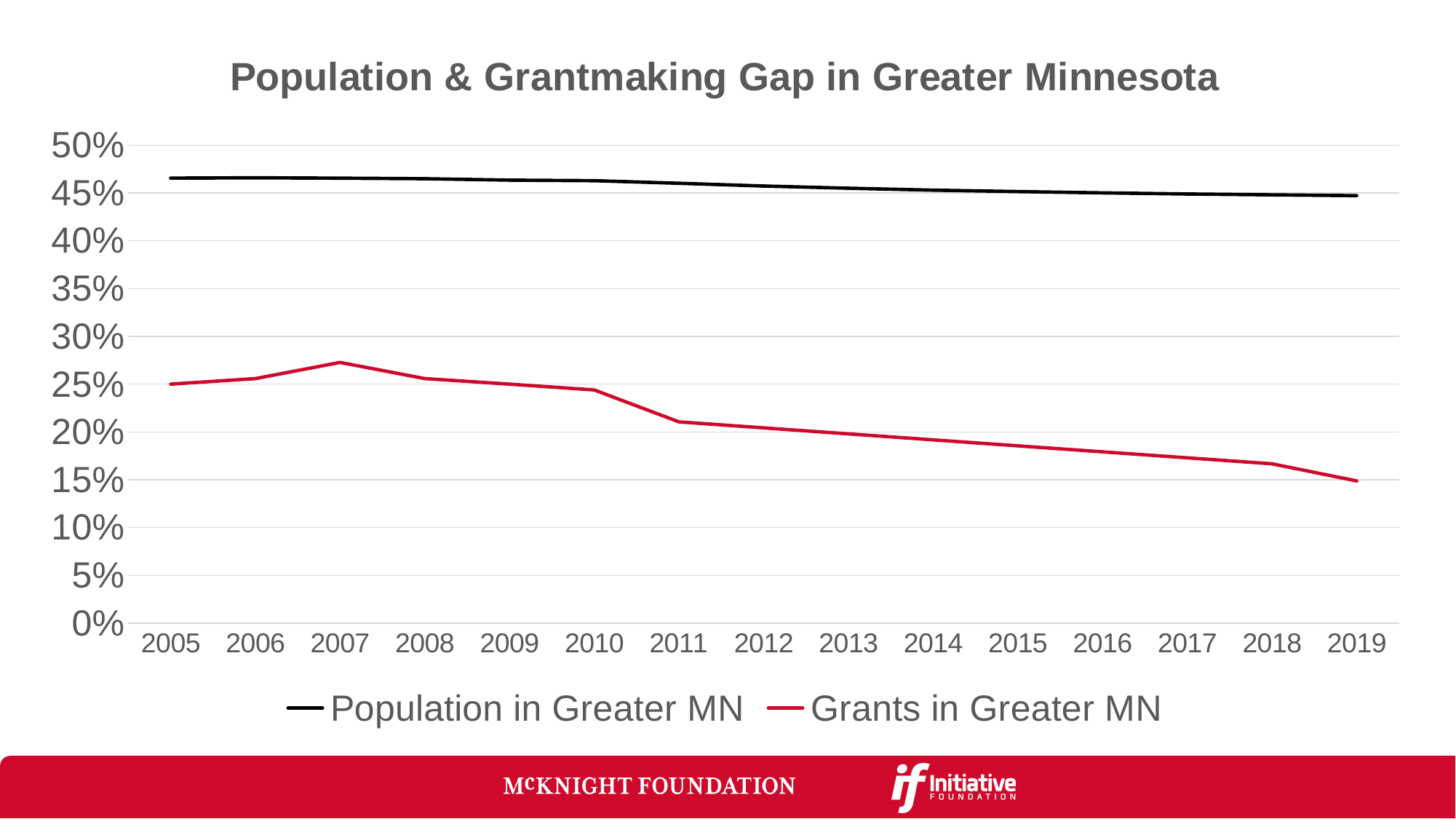
What kind of chart is shown on the slide? Line chart In which year is the value for Grants in Greater MN lowest? 2019 How many series does the legend list? 2 What is the title of the chart? Population & Grantmaking Gap in Greater Minnesota Which series has the higher value in 2012, Population in Greater MN or Grants in Greater MN? Population in Greater MN Does the value for Grants in Greater MN rise or fall from 2007 to 2019? Fall In which year is the value for Grants in Greater MN highest? 2007 Is the value for Population in Greater MN in 2005 greater or less than 45%? greater Which series is drawn in red? Grants in Greater MN Is the value for Grants in Greater MN in 2007 greater or less than 25%? greater Is the value for Grants in Greater MN in 2018 greater or less than 20%? less How many years are shown on the x axis? 15